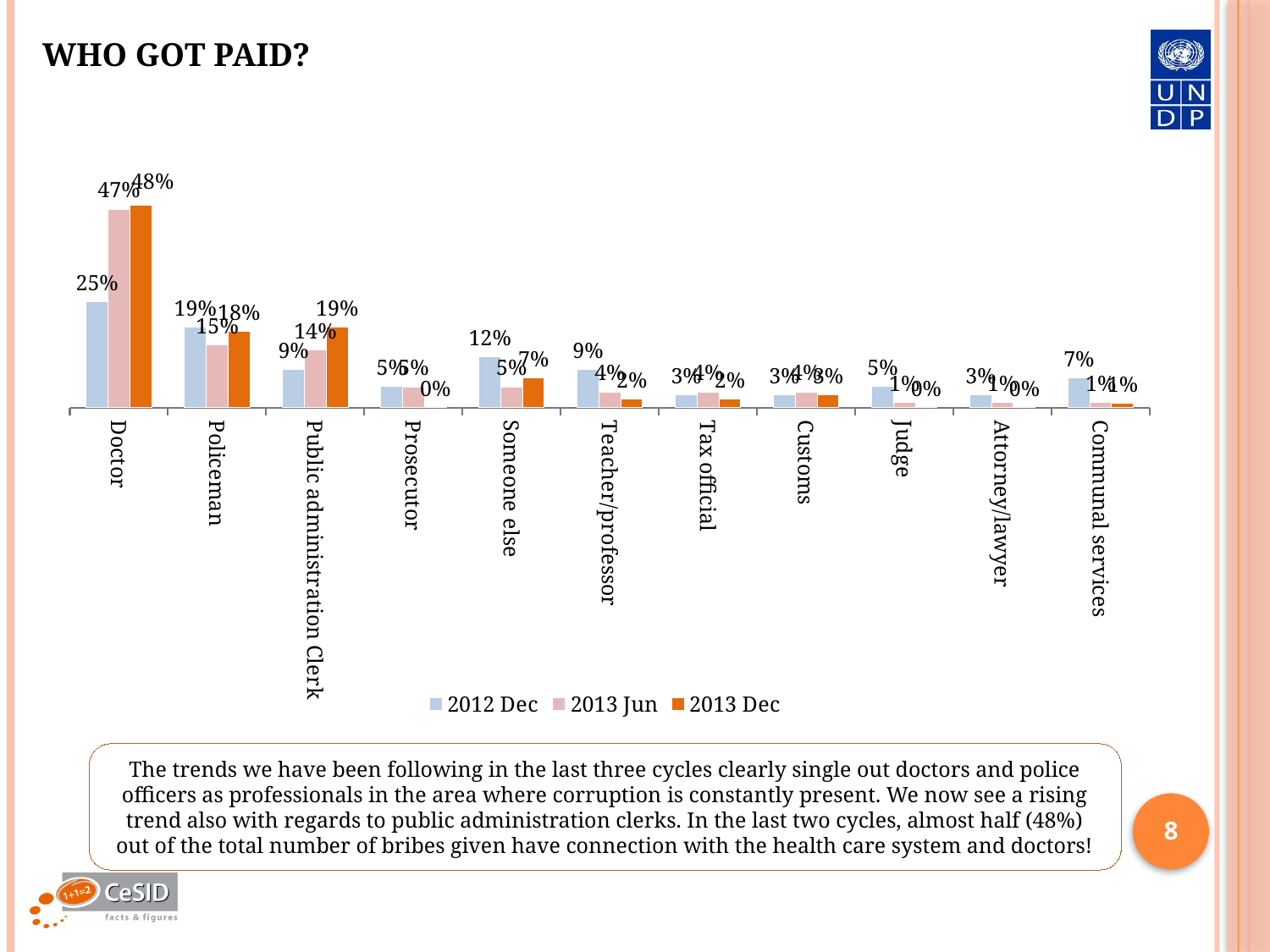
Do the values for Public administration Clerk rise or fall from 2012 Dec to 2013 Dec? Rise What is the value for Doctor in the 2012 Dec series? 25% In the 2012 Dec series, which is larger: Policeman or Public administration Clerk? Policeman How many categories are shown on the x axis of the chart? 11 What kind of chart is shown on the slide? Bar chart What is the value for Doctor in the 2013 Dec series? 48% What is the value for Public administration Clerk in the 2013 Dec series? 19% Which category has the highest value in the 2013 Dec series? Doctor What is the difference between the Doctor values for 2013 Dec and 2012 Dec? 23 percentage points What is the value for Someone else in the 2012 Dec series? 12% What are the three entries listed in the chart legend? 2012 Dec, 2013 Jun, 2013 Dec How many series does the legend list? 3